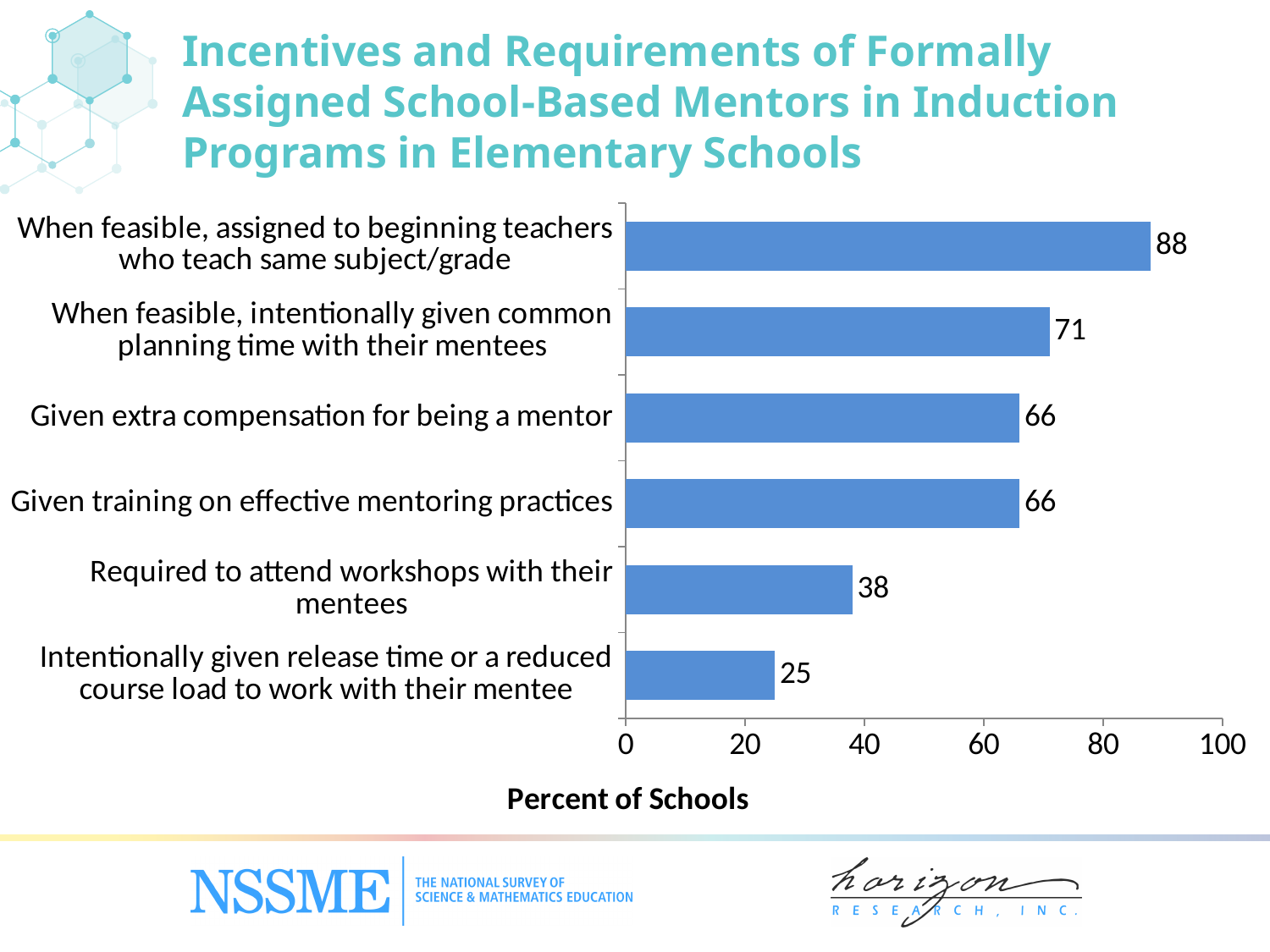
Which is larger: the value for 'When feasible, intentionally given common planning time with their mentees' or the value for 'Given training on effective mentoring practices'? When feasible, intentionally given common planning time with their mentees Which category has the highest percent of schools? When feasible, assigned to beginning teachers who teach same subject/grade What is the difference between the value for 'When feasible, assigned to beginning teachers who teach same subject/grade' and the value for 'When feasible, intentionally given common planning time with their mentees'? 17 What kind of chart is shown on the slide? Bar chart What is the label of the horizontal axis? Percent of Schools Which category has the lowest percent of schools? Intentionally given release time or a reduced course load to work with their mentee What is the difference between the value for 'Required to attend workshops with their mentees' and the value for 'Intentionally given release time or a reduced course load to work with their mentee'? 13 What percent of schools intentionally give mentors release time or a reduced course load to work with their mentee? 25 What is the value for 'Required to attend workshops with their mentees'? 38 How many categories are shown in the chart? 6 What is the value for 'Given extra compensation for being a mentor'? 66 What percent of schools report that mentors are, when feasible, assigned to beginning teachers who teach the same subject/grade? 88